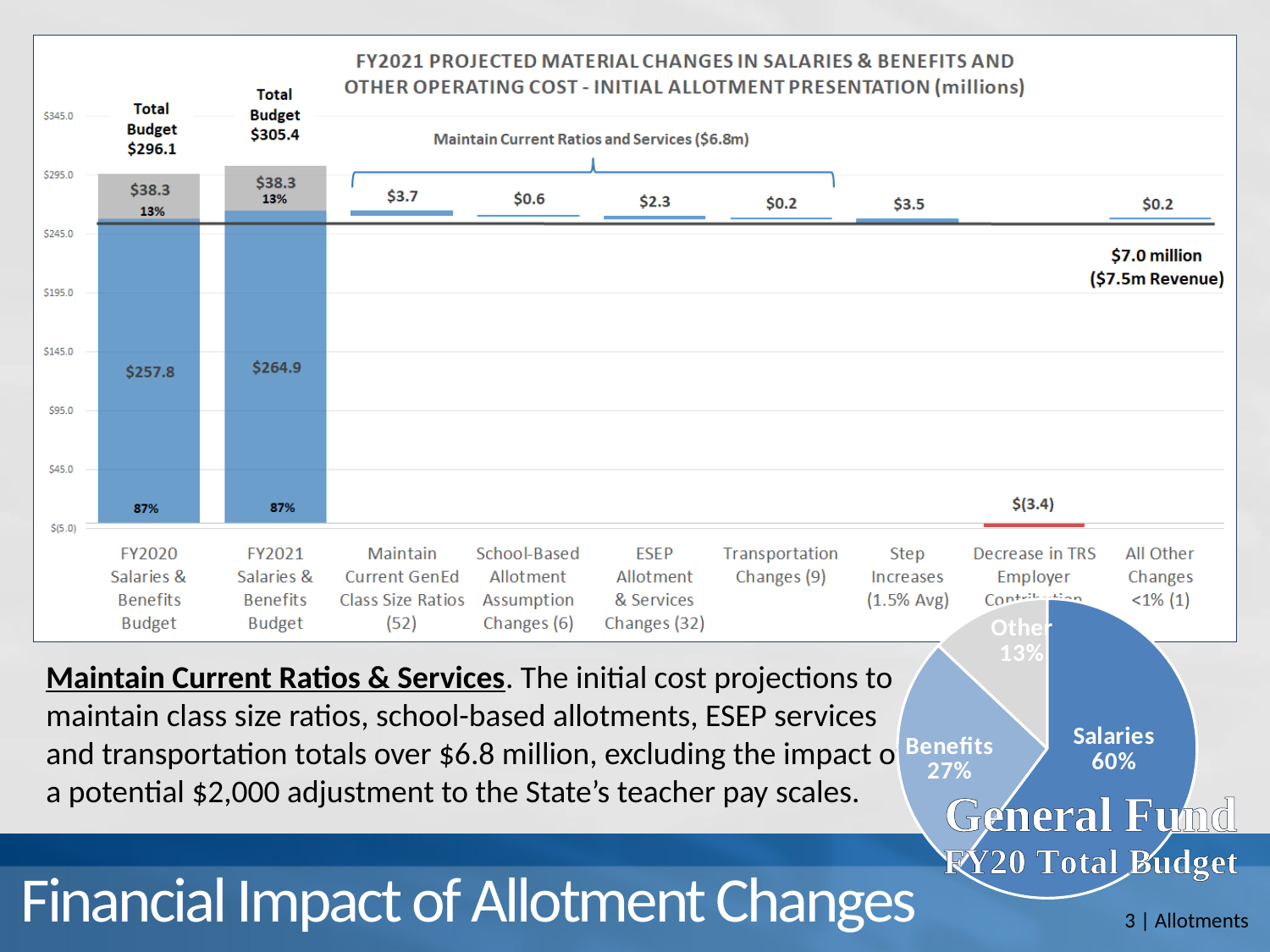
How many slices does the General Fund FY20 Total Budget pie chart have? 3 In the General Fund FY20 Total Budget pie chart, what share does Salaries have? 60% In the FY2021 Projected Material Changes chart, what is the difference between the FY2021 Total Budget ($305.4) and the FY2020 Total Budget ($296.1)? $9.3 In the FY2021 Projected Material Changes chart, what total is shown for the bracket labelled Maintain Current Ratios and Services? $6.8m In the FY2021 Projected Material Changes chart, which change category has the lowest value? Decrease in TRS Employer Contribution In the FY2021 Projected Material Changes chart, what is the value shown for ESEP Allotment & Services Changes (32)? $2.3 In the FY2021 Projected Material Changes chart, which is larger: Step Increases (1.5% Avg) or School-Based Allotment Assumption Changes (6)? Step Increases (1.5% Avg) In the FY2021 Projected Material Changes chart, what is the value shown for Decrease in TRS Employer Contribution? $(3.4) In the General Fund FY20 Total Budget pie chart, what percentage is shown for Benefits? 27% In the FY2021 Projected Material Changes chart, what is the value of the large blue segment of the FY2020 Salaries & Benefits Budget bar? $257.8 What kind of chart is the FY2021 Projected Material Changes chart? Bar chart In the FY2021 Projected Material Changes chart, what is the Total Budget shown for the FY2021 Salaries & Benefits Budget bar? $305.4